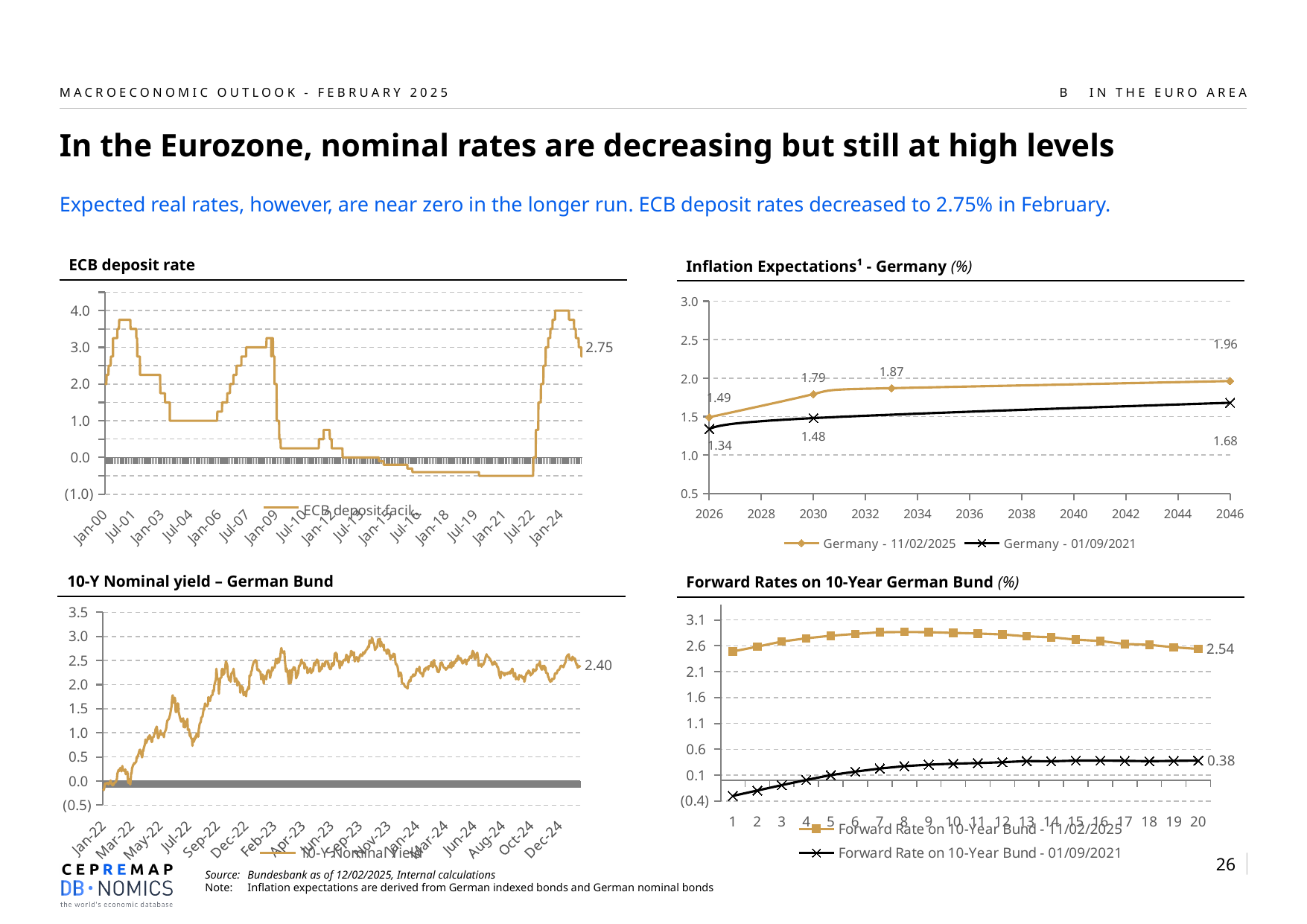
On the Forward Rates on 10-Year German Bund chart, what is the value at point 20 for the 11/02/2025 series? 2.54 On the Inflation Expectations - Germany chart, does the Germany - 11/02/2025 series rise or fall from 2026 to 2046? rise On the Inflation Expectations - Germany chart, what is the difference between the two series in 2030? 0.31 On the ECB deposit rate chart, what is the latest value labelled at the end of the line? 2.75 On the Forward Rates on 10-Year German Bund chart, what is the difference between the two series at point 20? 2.16 On the Forward Rates on 10-Year German Bund chart, how many points are shown on the x axis? 20 On the Inflation Expectations - Germany chart, what is the value for Germany - 01/09/2021 in 2026? 1.34 On the 10-Y Nominal yield – German Bund chart, what is the latest value labelled at the end of the line? 2.40 On the Inflation Expectations - Germany chart, how many series does the legend list? 2 What kind of chart is the 10-Y Nominal yield – German Bund chart? line chart On the Inflation Expectations - Germany chart, what is the value for Germany - 11/02/2025 in 2046? 1.96 On the ECB deposit rate chart, is the peak value reached in 2024 greater or less than 3.0? greater